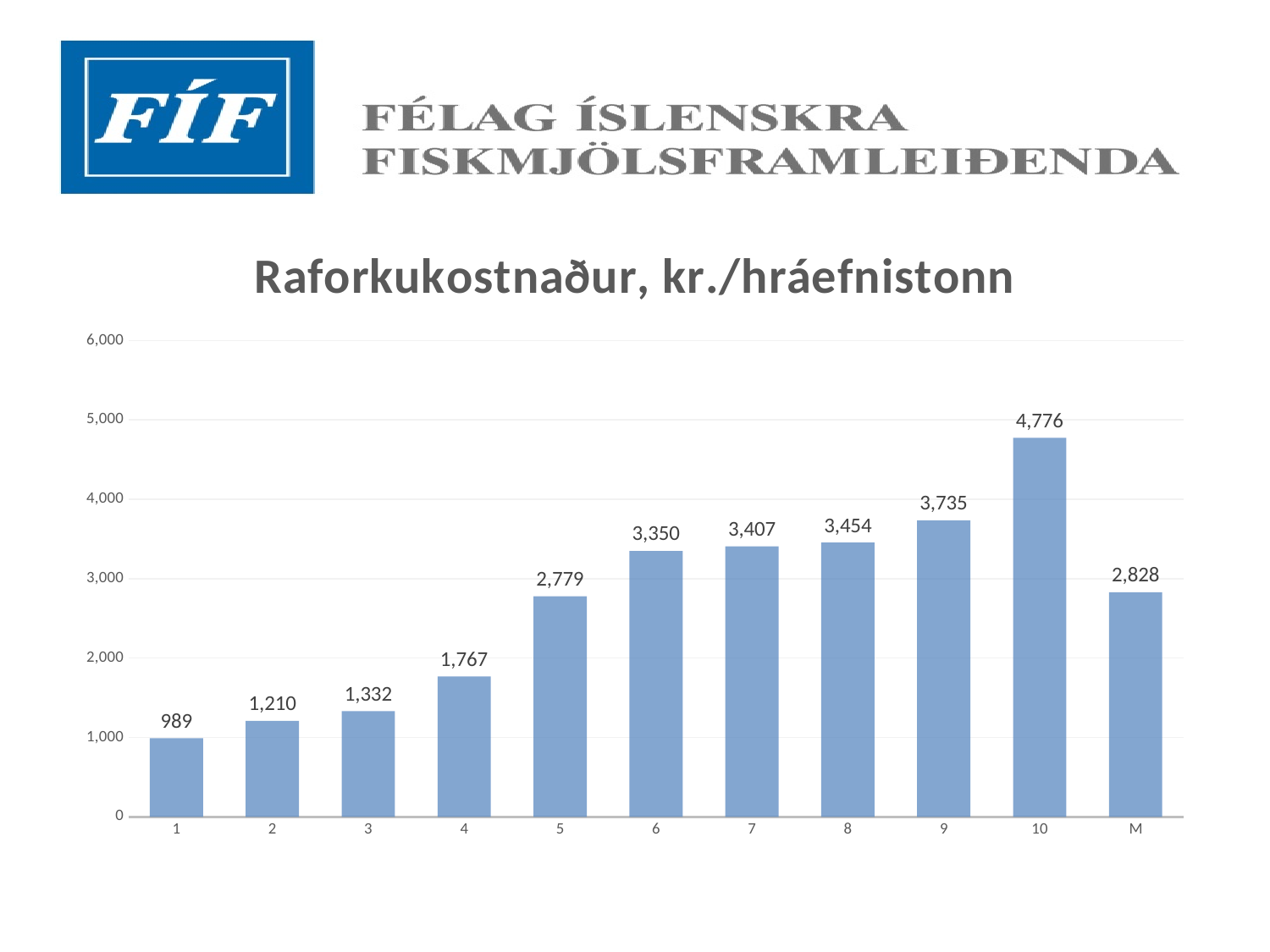
Do the values rise or fall from category 1 to category 10? rise Is the value for category 6 greater or less than 3,000? greater Which category has the lowest value? 1 What is the title of the chart? Raforkukostnaður, kr./hráefnistonn How many categories are shown on the x axis? 11 What is the value for category 1? 989 What is the difference between the values for category 10 and category 9? 1,041 Which category has the highest value? 10 What is the value for category 5? 2,779 What kind of chart is shown on the slide? bar chart What is the value for category M? 2,828 Which is larger, the value for category 4 or the value for category 3? 4